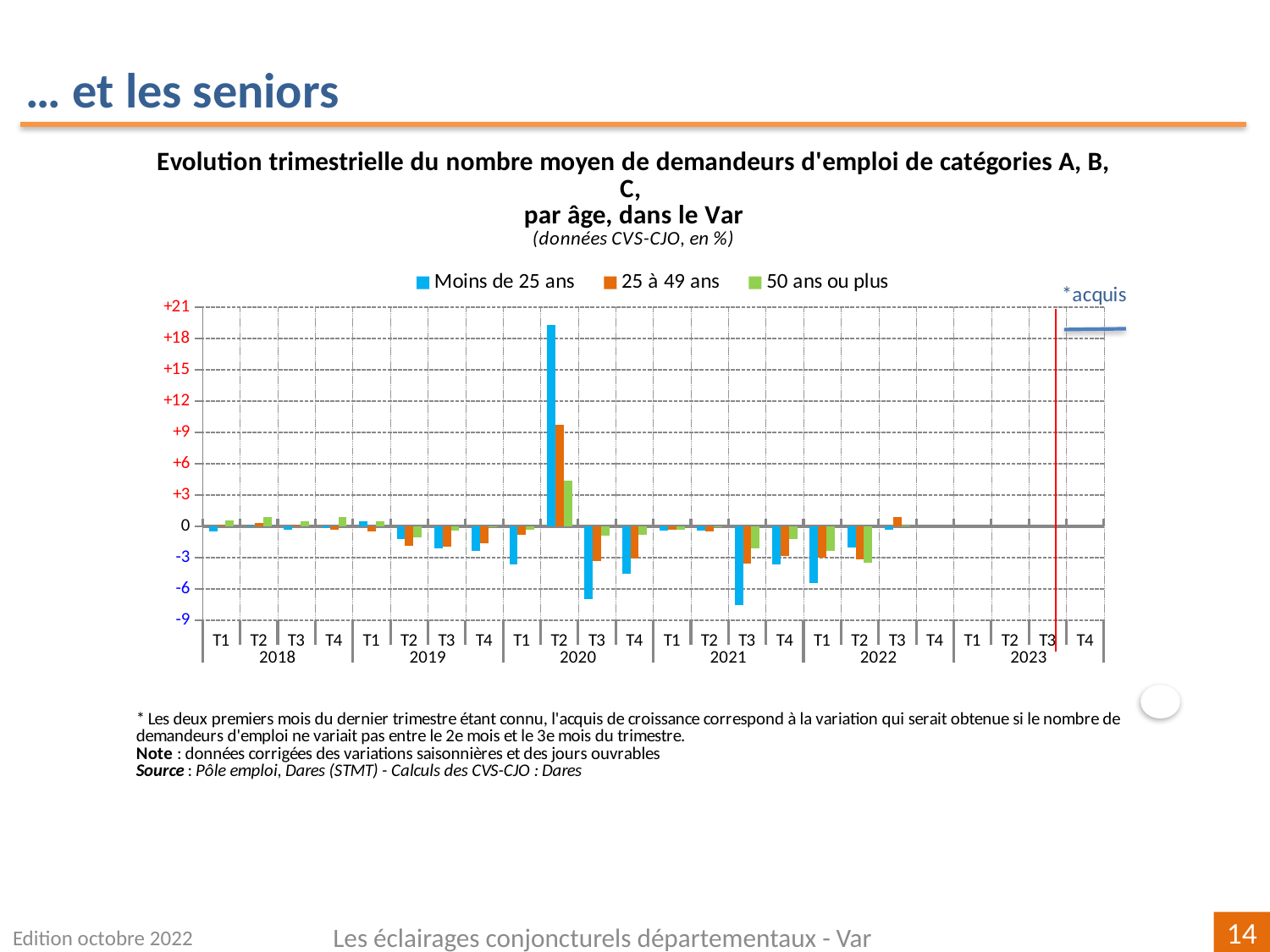
In which quarter does the 'Moins de 25 ans' series reach its highest value? T2 2020 Is the value for 'Moins de 25 ans' in T3 2021 greater or less than -6? less How many series does the legend list? 3 Which series is shown in green in the legend? 50 ans ou plus What label is written next to the red vertical line at the right of the chart? *acquis In which quarter does the '50 ans ou plus' series reach its highest value? T2 2020 How many years are labelled along the x axis? 6 Is the value for '25 à 49 ans' in T2 2020 greater or less than 6? greater In T2 2020, which series has the larger value: 'Moins de 25 ans' or '25 à 49 ans'? Moins de 25 ans Is the value for 'Moins de 25 ans' in T2 2020 greater or less than 18? greater What kind of chart is shown on the slide? bar chart